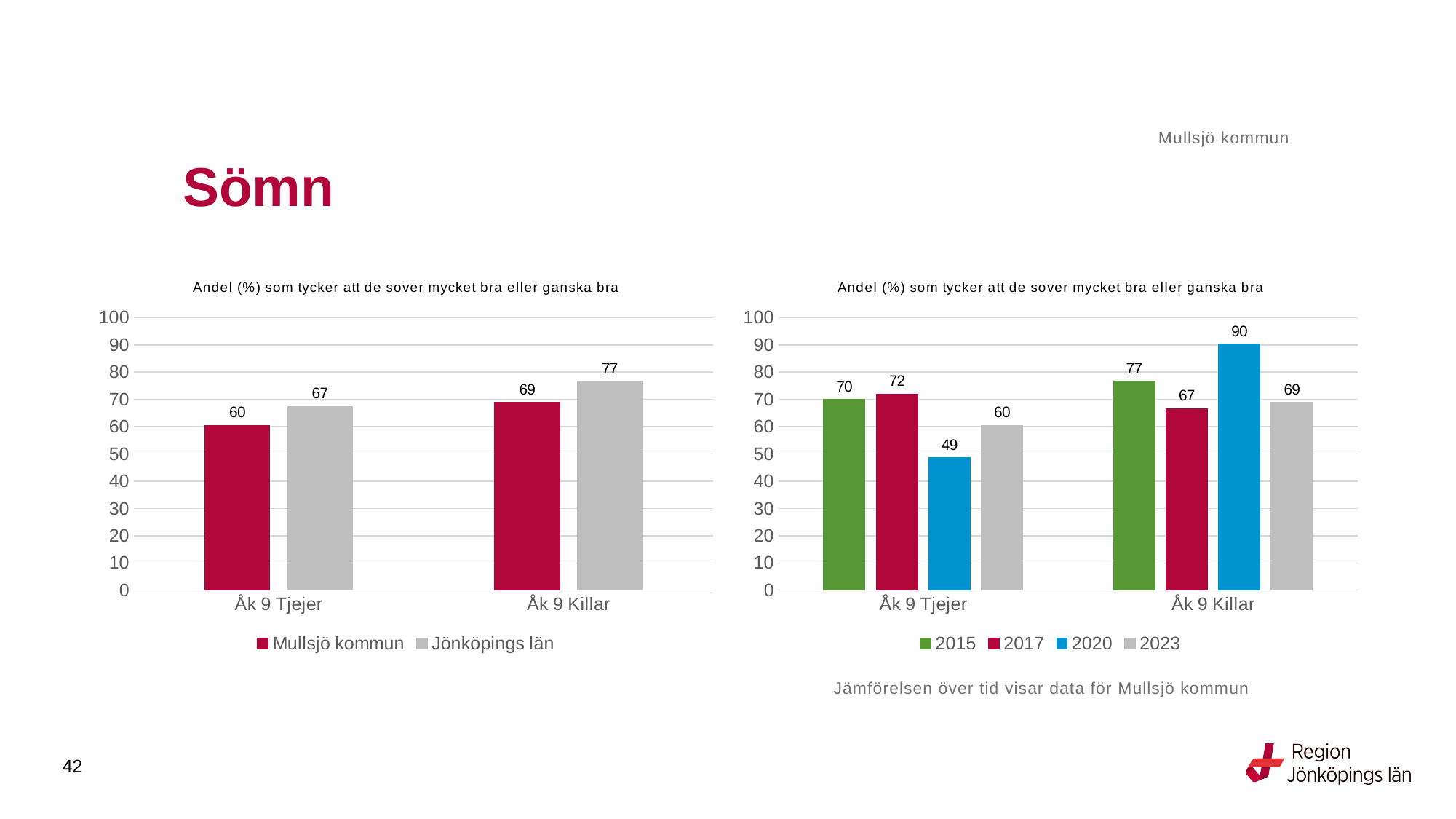
In the left chart, what is the value for Jönköpings län for Åk 9 Killar? 77 In the right chart, how many series does the legend list? 4 What kind of chart is the right chart? Bar chart In the left chart, how many series does the legend list? 2 In the right chart, which year has the highest value for Åk 9 Killar? 2020 In the right chart, what is the difference between the 2020 values for Åk 9 Killar and Åk 9 Tjejer? 41 In the left chart, what is the value for Mullsjö kommun for Åk 9 Tjejer? 60 In the right chart, what is the value for 2023 for Åk 9 Killar? 69 In the right chart, which year has the lowest value for Åk 9 Tjejer? 2020 In the right chart, what is the value for 2020 for Åk 9 Tjejer? 49 In the left chart, which is larger for Åk 9 Tjejer: Mullsjö kommun or Jönköpings län? Jönköpings län In the left chart, what is the difference between Jönköpings län and Mullsjö kommun for Åk 9 Killar? 8